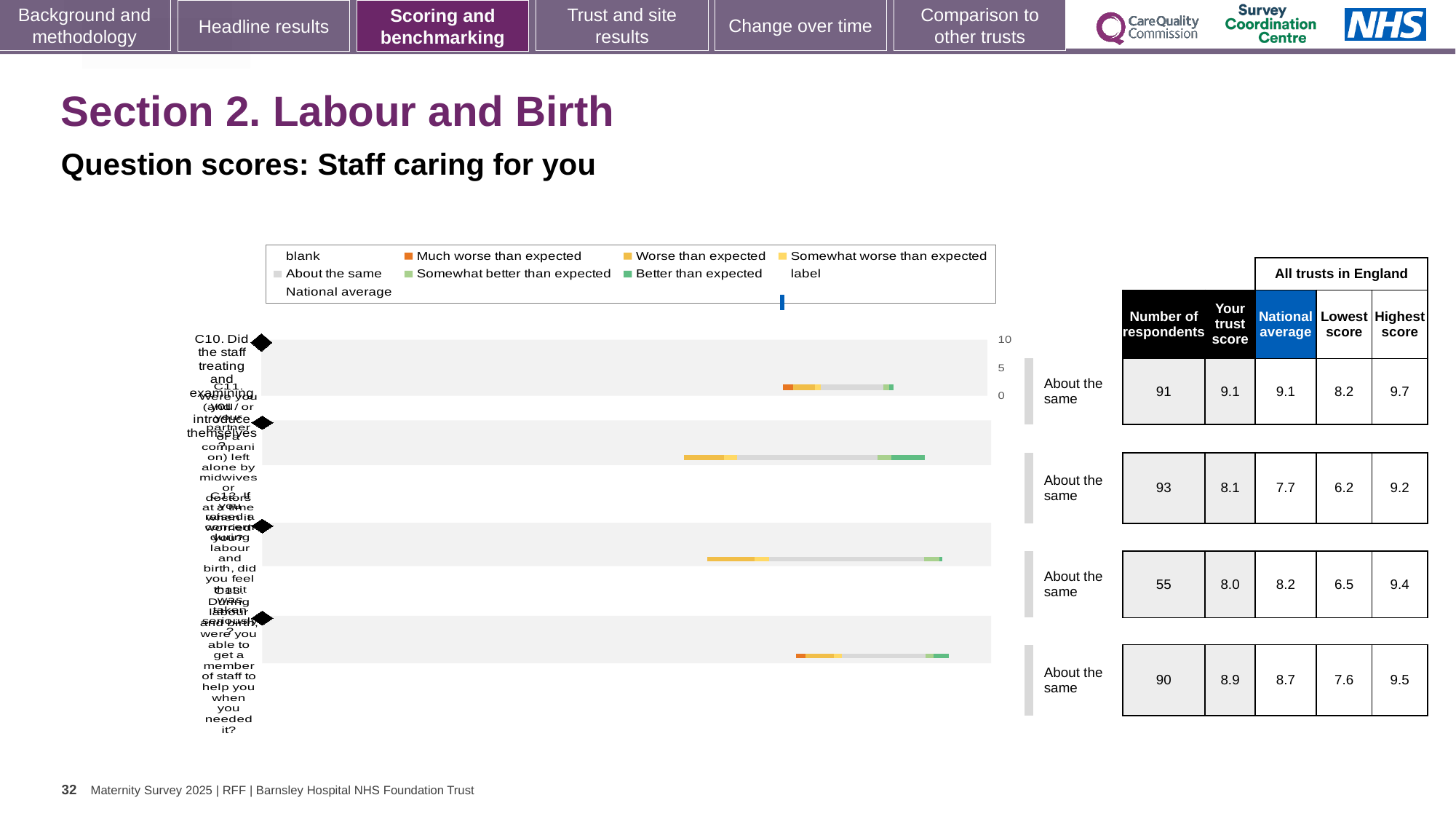
Which row has the highest number of respondents? the second row (C11), 93 For the second row (C11), what is the difference between the trust score and the national average? 0.4 What is the lowest score among all trusts in England for the second row (C11)? 6.2 For the third row (C12), which is larger: the trust score or the national average? the national average What is the trust score for the second row (C11)? 8.1 What is the national average for the third row (C12)? 8.2 What kind of chart is shown on the slide? bar chart What benchmark category is shown for all four questions? About the same Which row has the lowest number of respondents? the third row (C12), 55 What is the number of respondents for the first row (C10)? 91 How many questions (rows) are plotted in the chart? 4 What is the highest score among all trusts in England for the fourth row (C13)? 9.5